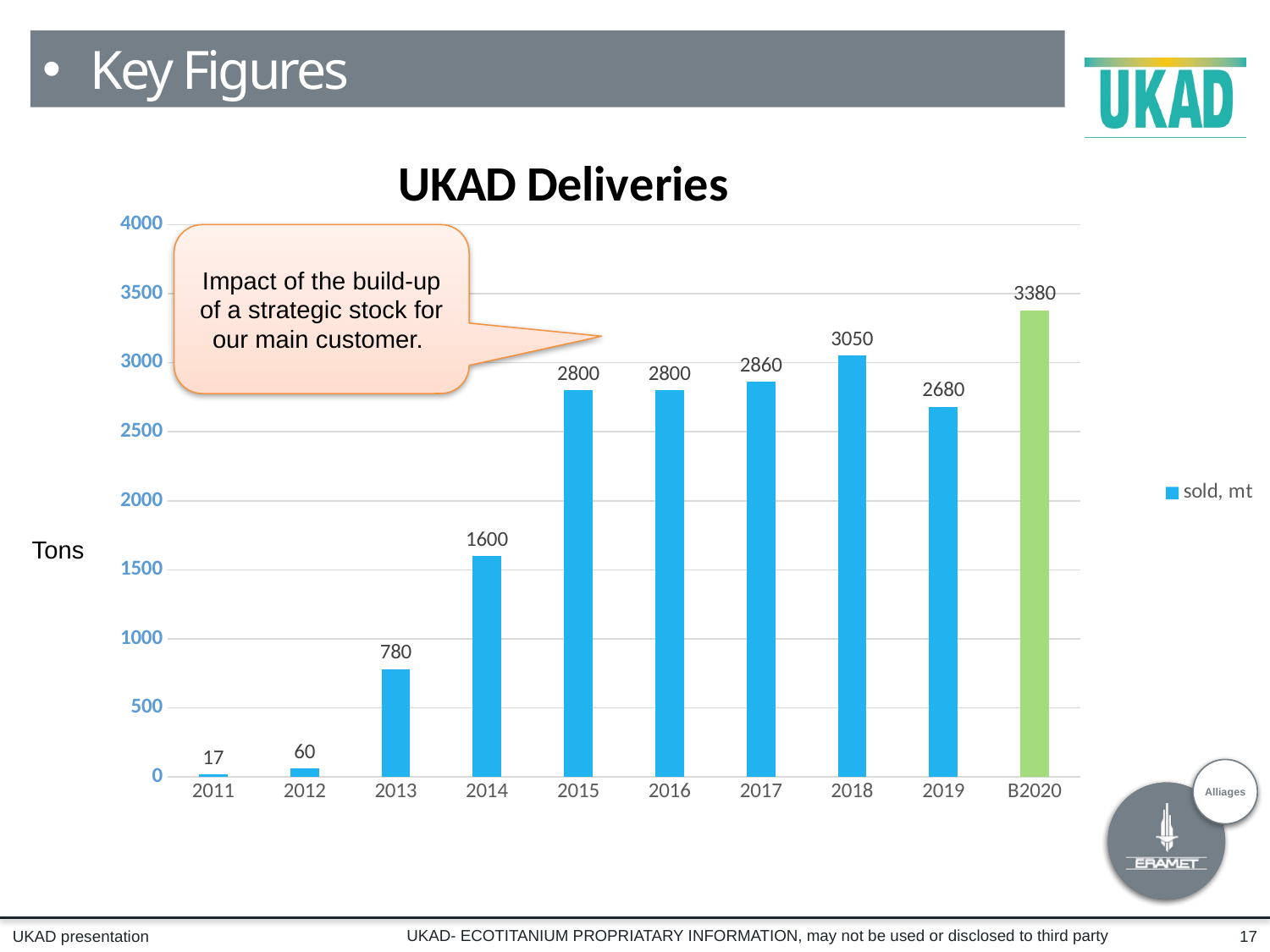
What is the value for B2020 in the UKAD Deliveries chart? 3380 Which is larger in the UKAD Deliveries chart, the value for 2017 or the value for 2019? 2017 How many series does the legend of the UKAD Deliveries chart list? 1 What is the legend entry in the UKAD Deliveries chart? sold, mt What is the value for 2018 in the UKAD Deliveries chart? 3050 Do the values in the UKAD Deliveries chart rise or fall from 2011 to 2018? rise How many categories are shown on the x axis of the UKAD Deliveries chart? 10 Which category has the lowest value in the UKAD Deliveries chart? 2011 What is the value for 2013 in the UKAD Deliveries chart? 780 Which category has the highest value in the UKAD Deliveries chart? B2020 What kind of chart is the UKAD Deliveries chart? bar chart What is the difference between the values for 2018 and 2019 in the UKAD Deliveries chart? 370